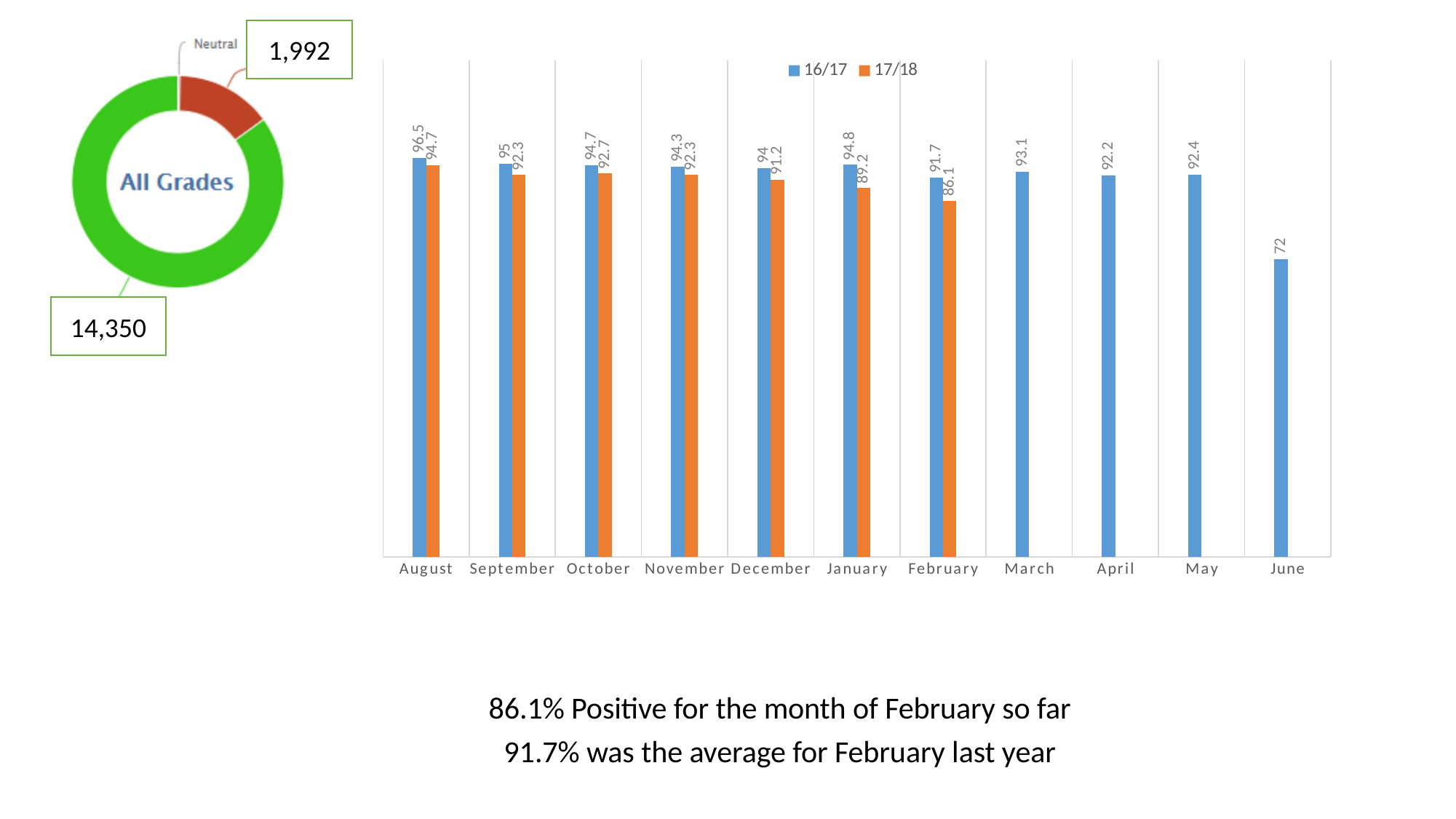
In the donut chart titled 'All Grades', what is the value of the Neutral segment? 1,992 In the bar chart on the right, how many series does the legend list? 2 What kind of chart is the chart on the right of the slide? bar chart In the bar chart on the right, which month has the highest 16/17 value? August In the bar chart on the right, which month has the lowest 17/18 value? February In the bar chart on the right, what is the difference between the 16/17 and 17/18 values for February? 5.6 In the bar chart on the right, which month has the lowest 16/17 value? June In the donut chart titled 'All Grades', what is the value of the green segment? 14,350 In the bar chart on the right, what is the 16/17 value for August? 96.5 In the bar chart on the right, how many months are shown on the x axis? 11 In the bar chart on the right, which series has the larger value for January, 16/17 or 17/18? 16/17 In the bar chart on the right, what is the 17/18 value for February? 86.1